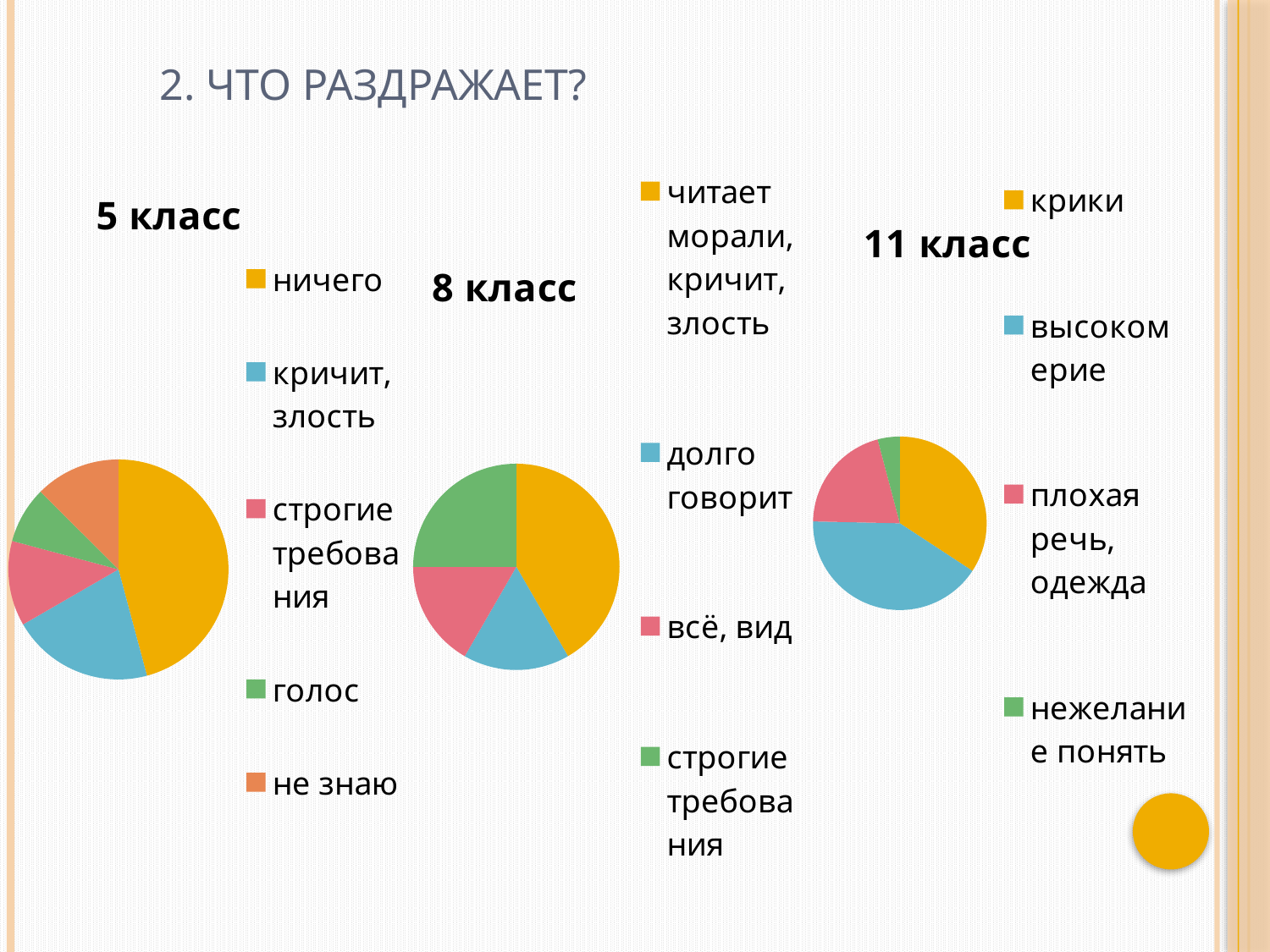
In the "8 класс" chart, how many categories does the legend list? 4 In the "8 класс" chart, which slice is larger: "строгие требования" or "читает морали, кричит, злость"? читает морали, кричит, злость What is the title of the slide? 2. ЧТО РАЗДРАЖАЕТ? In the "11 класс" chart, how many categories does the legend list? 4 How many pie charts are shown on the slide? 3 In the "5 класс" chart, which category has the largest slice? ничего In the "5 класс" chart, which slice is larger: "ничего" or "кричит, злость"? ничего In the "5 класс" chart, how many categories does the legend list? 5 In the "11 класс" chart, which category has the largest slice? высокомерие In the "11 класс" chart, which category has the smallest slice? нежелание понять What kind of chart is the "5 класс" chart? pie chart In the "8 класс" chart, which category has the largest slice? читает морали, кричит, злость